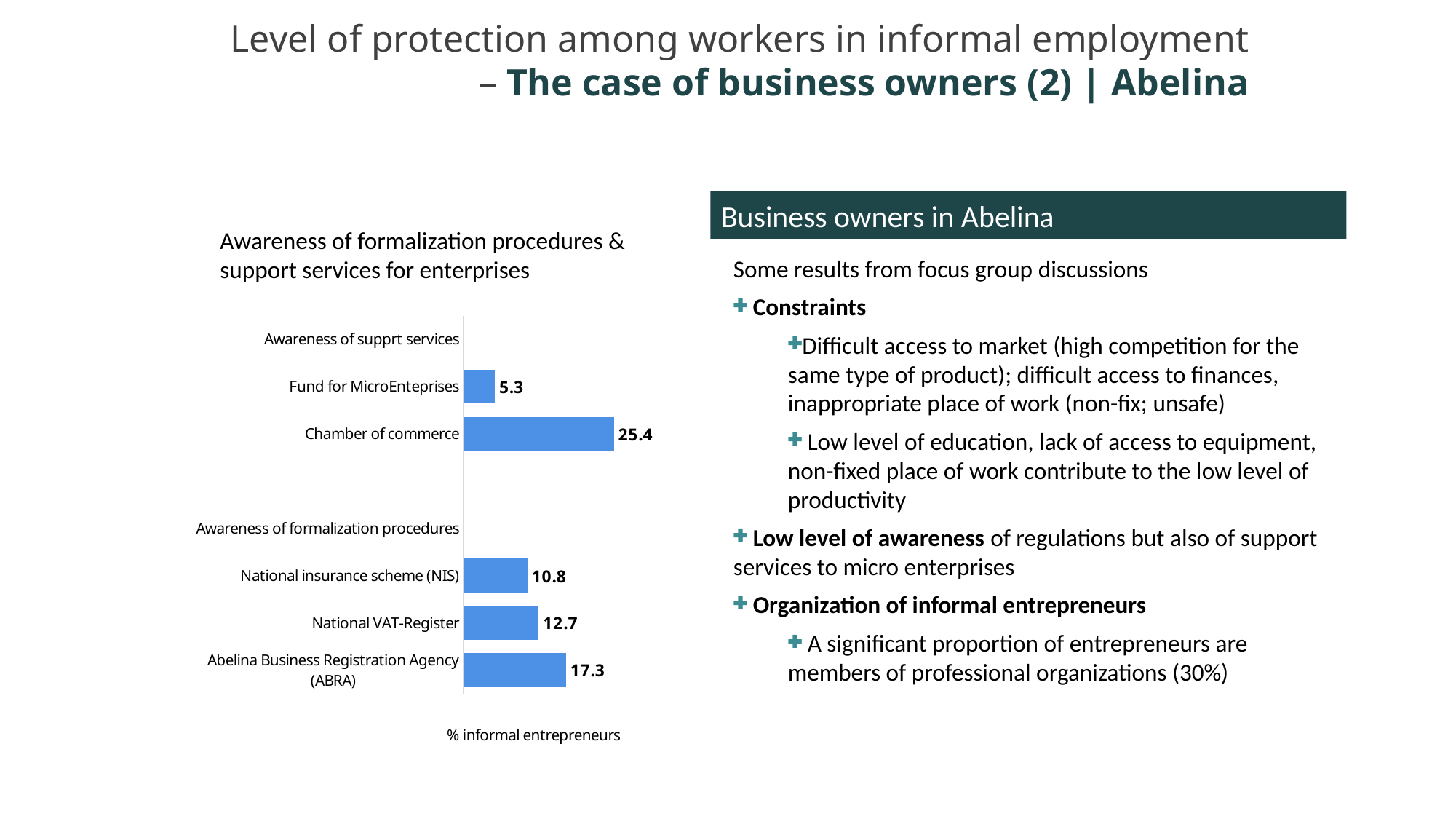
What is the value for Abelina Business Registration Agency (ABRA)? 17.3 What is the label on the horizontal axis of the chart? % informal entrepreneurs How many bars are plotted in the chart? 5 Which is larger, the value for National VAT-Register or the value for National insurance scheme (NIS)? National VAT-Register Which category has the highest value? Chamber of commerce What is the value for National insurance scheme (NIS)? 10.8 What is the value for Chamber of commerce? 25.4 Which category with a plotted bar has the lowest value? Fund for MicroEnteprises What kind of chart is shown on the slide? Bar chart What is the value for Fund for MicroEnteprises? 5.3 What is the difference between the values for Abelina Business Registration Agency (ABRA) and National VAT-Register? 4.6 What is the difference between the values for Chamber of commerce and Fund for MicroEnteprises? 20.1